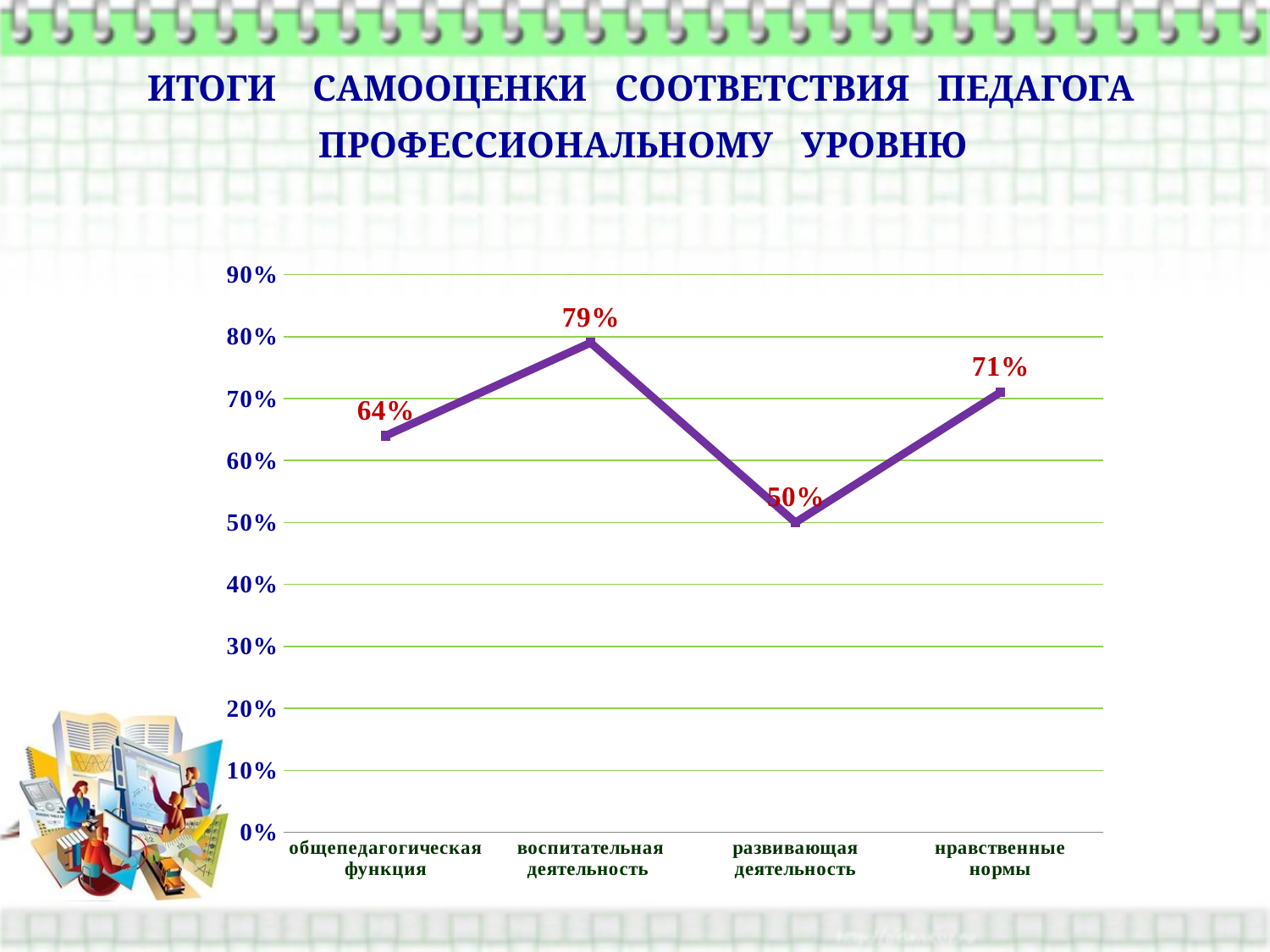
Which category has the highest value? воспитательная деятельность Is the value for развивающая деятельность greater or less than 60%? less Which is larger, the value for нравственные нормы or the value for общепедагогическая функция? нравственные нормы What is the value for развивающая деятельность? 50% Which category has the lowest value? развивающая деятельность What kind of chart is shown on the slide? line chart What is the difference between the values for воспитательная деятельность and развивающая деятельность? 29% What is the value for нравственные нормы? 71% How many categories are shown on the x axis? 4 What is the value for воспитательная деятельность? 79% What is the value for общепедагогическая функция? 64% What is the title of the slide? ИТОГИ САМООЦЕНКИ СООТВЕТСТВИЯ ПЕДАГОГА ПРОФЕССИОНАЛЬНОМУ УРОВНЮ